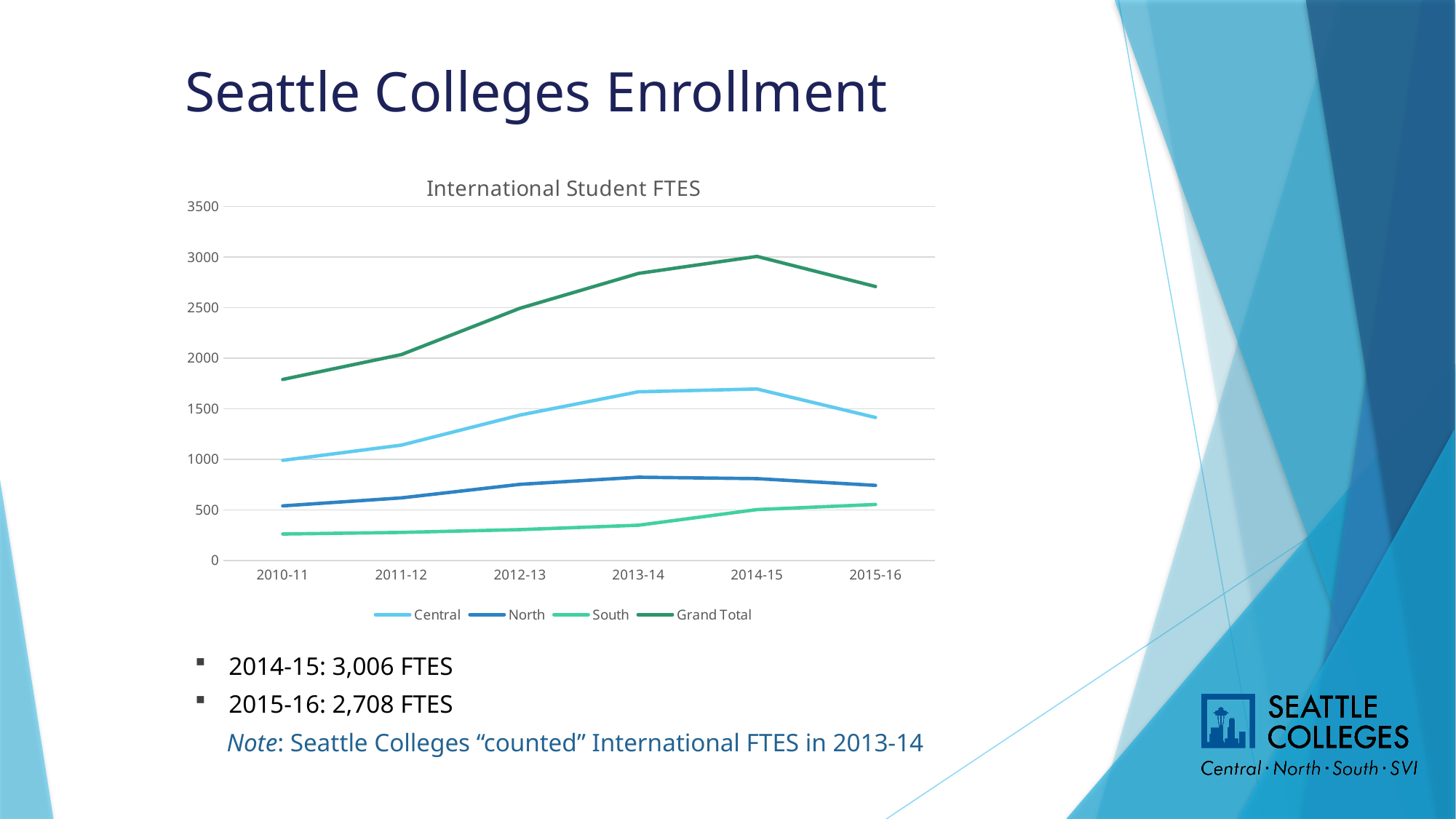
In which year does the Grand Total line reach its highest point? 2014-15 Is the Central value for 2014-15 greater or less than 1500? greater Does the South line rise or fall from 2010-11 to 2015-16? rise How many series does the chart legend list? 4 Is the Grand Total value for 2010-11 greater or less than 2000? less What was the Grand Total of International Student FTES in 2015-16? 2,708 FTES How many academic years are plotted along the x axis? 6 What kind of chart is shown on the slide? line chart Which series is larger in 2015-16, Central or North? Central By how much did the Grand Total FTES fall from 2014-15 to 2015-16? 298 What was the Grand Total of International Student FTES in 2014-15? 3,006 FTES What is the title of the chart? International Student FTES